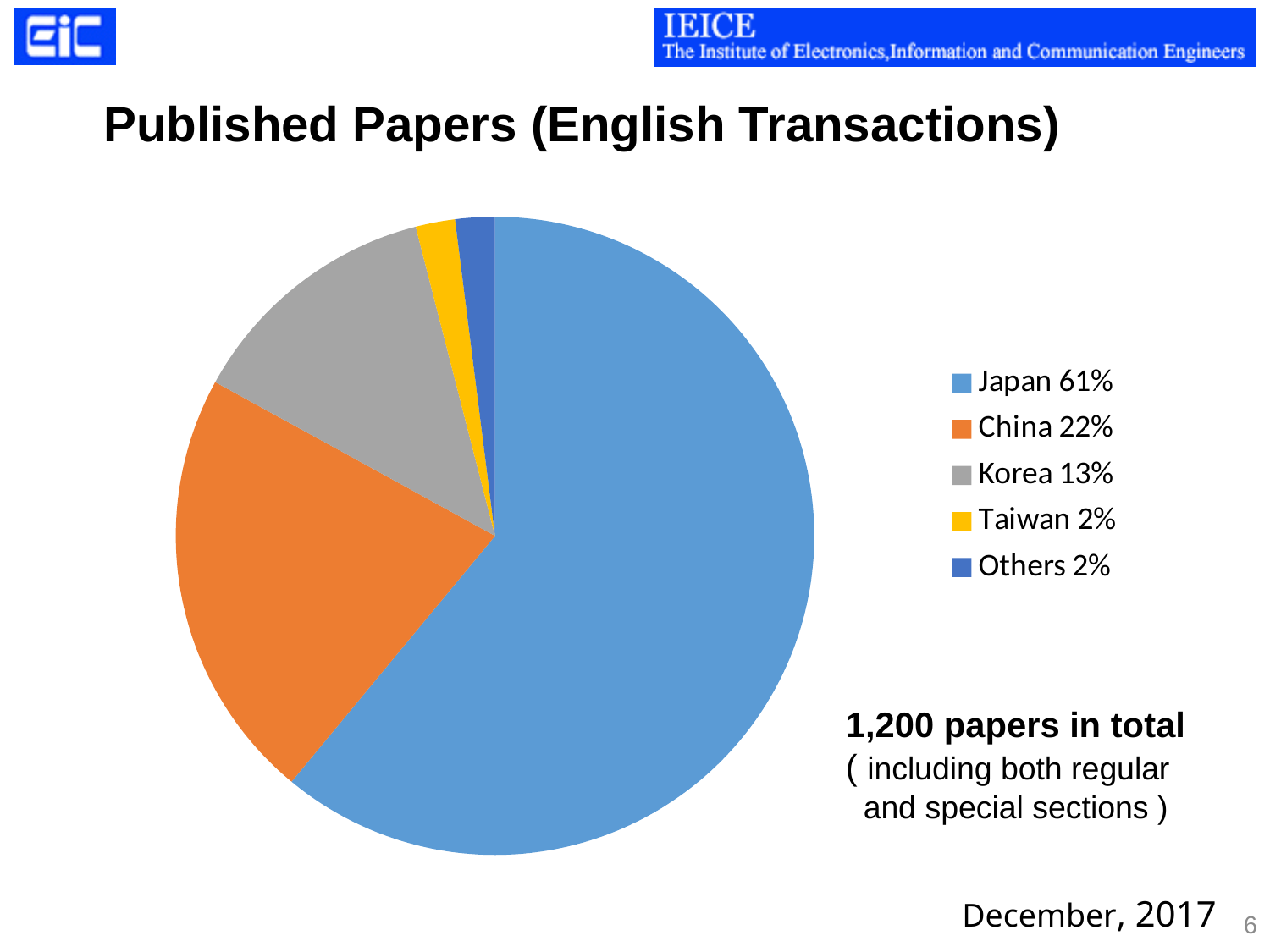
Which colour represents Taiwan in the pie chart? Yellow What is the total number of papers stated on the slide? 1,200 What share of published papers is from Korea? 13% Which has a larger share of published papers, China or Korea? China What is the difference in percentage points between Japan's share and China's share? 39 What share of published papers is from Taiwan? 2% What is the difference in percentage points between China's share and Korea's share? 9 What share of published papers is from Japan? 61% What kind of chart is shown on the slide? Pie chart Which country has the largest share of published papers? Japan What share of published papers is from China? 22% How many slices does the pie chart have? 5